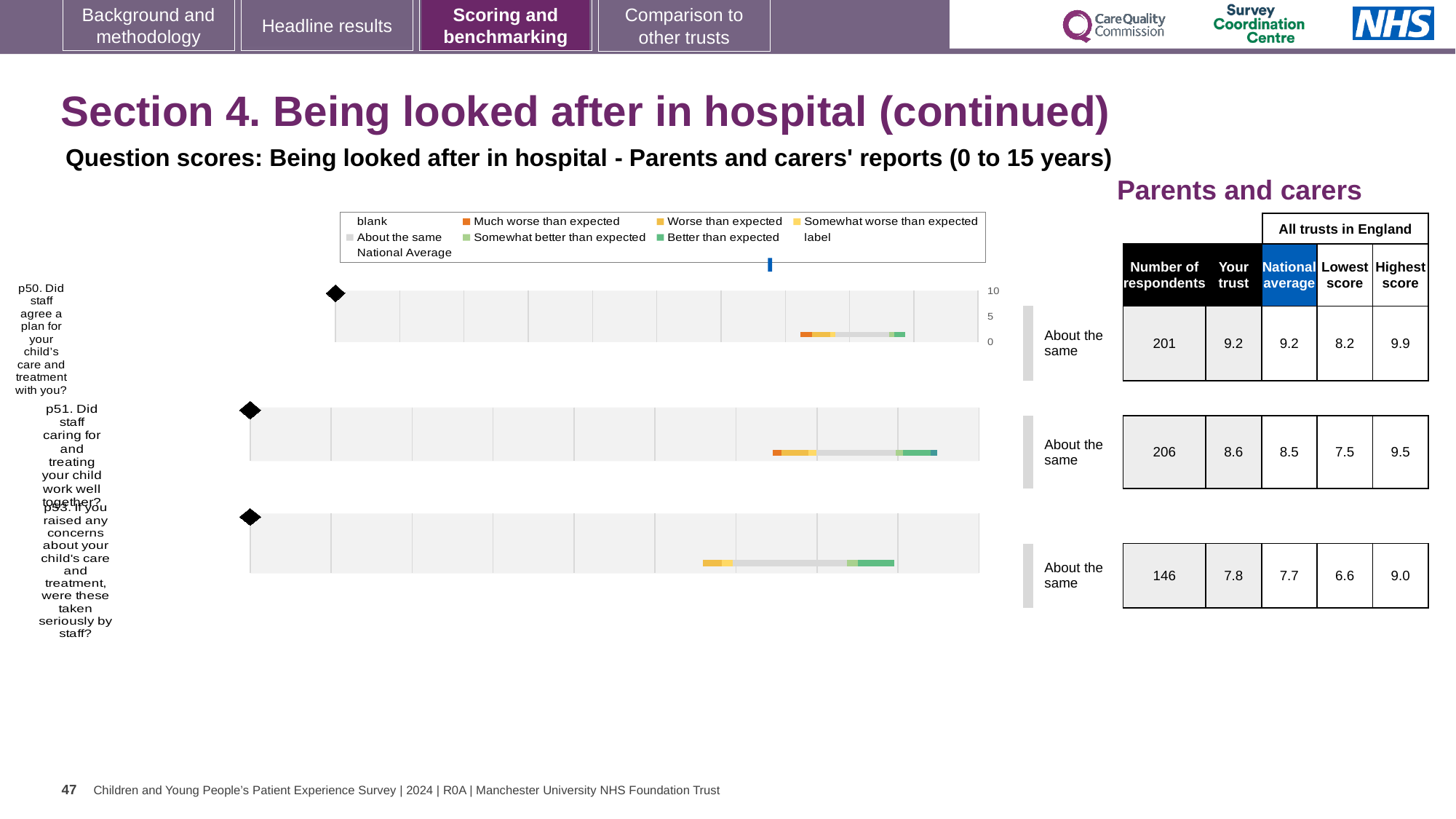
How many questions (charts) are shown on the slide? 3 In the table next to the p51 chart, what is the National average score? 8.5 For p51, which is larger: the 'Your trust' score or the National average? Your trust In the table next to the p53 chart, what is the Lowest score across all trusts in England? 6.6 What is the highest tick value shown on the axis of the p50 chart? 10 In the table next to the p50 chart, what is the 'Your trust' score? 9.2 Which question has the lowest 'Your trust' score in the table? p53 What benchmark rating label is shown beside each of the three charts? About the same In the table next to the p53 chart, what is the number of respondents? 146 For p50, what is the difference between the Highest score and the Lowest score in the table? 1.7 Which question has the highest 'Your trust' score in the table? p50 What kind of chart is used to show the question scores for p50, p51 and p53? bar chart